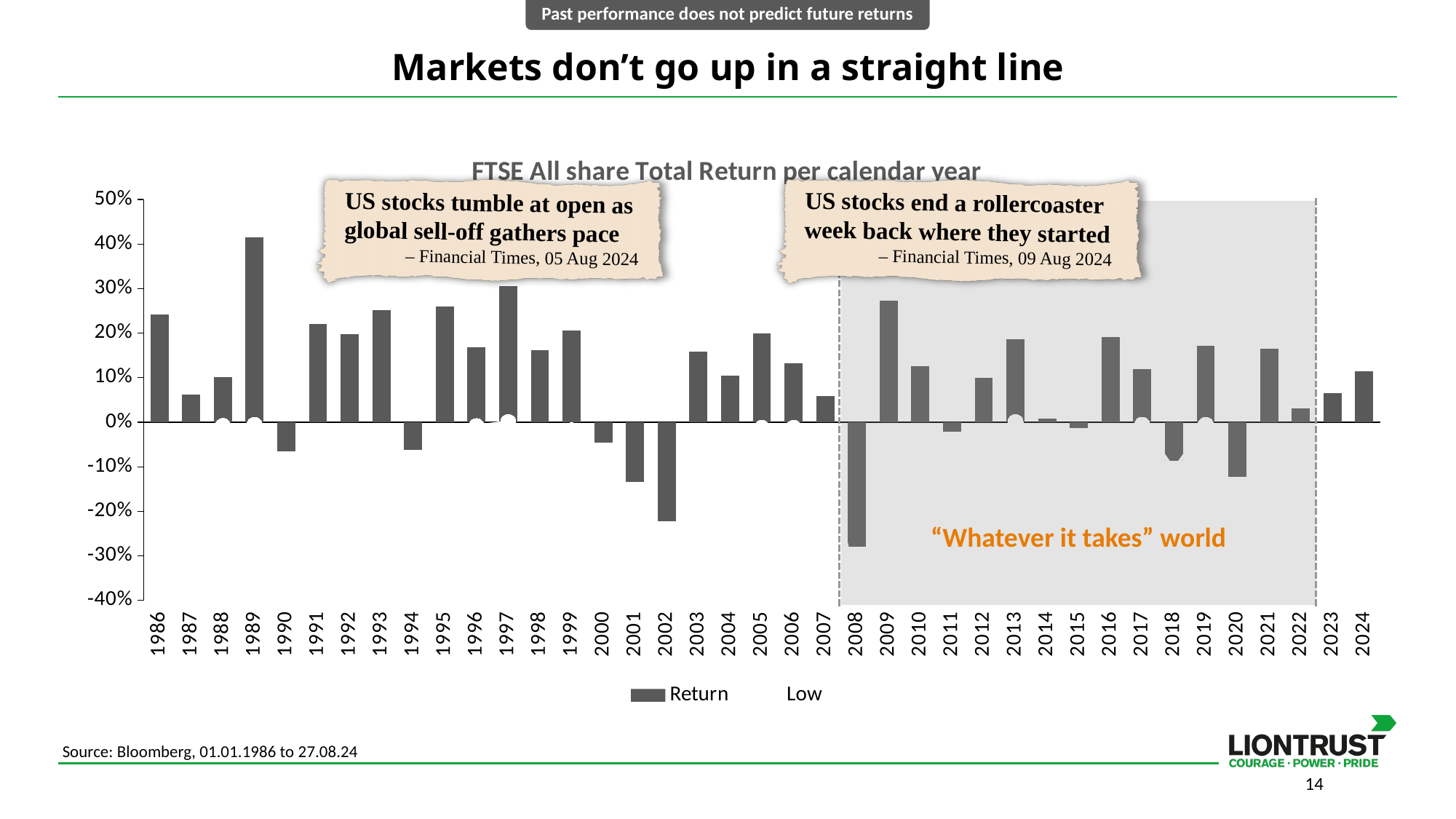
Which year has the larger total return, 1989 or 1997? 1989 Is the value for 1989 greater or less than 30%? greater What kind of chart is shown on the slide? Bar chart Is the value for 2009 greater or less than 20%? greater What label is written inside the shaded region covering 2008 to 2022? "Whatever it takes" world Is the value for 2002 greater or less than -10%? less Which year has the highest total return in the chart? 1989 How many series does the chart legend list? 2 What is the title of the chart? FTSE All share Total Return per calendar year Which year has the lowest total return in the chart? 2008 How many calendar years are shown on the x axis of the chart? 39